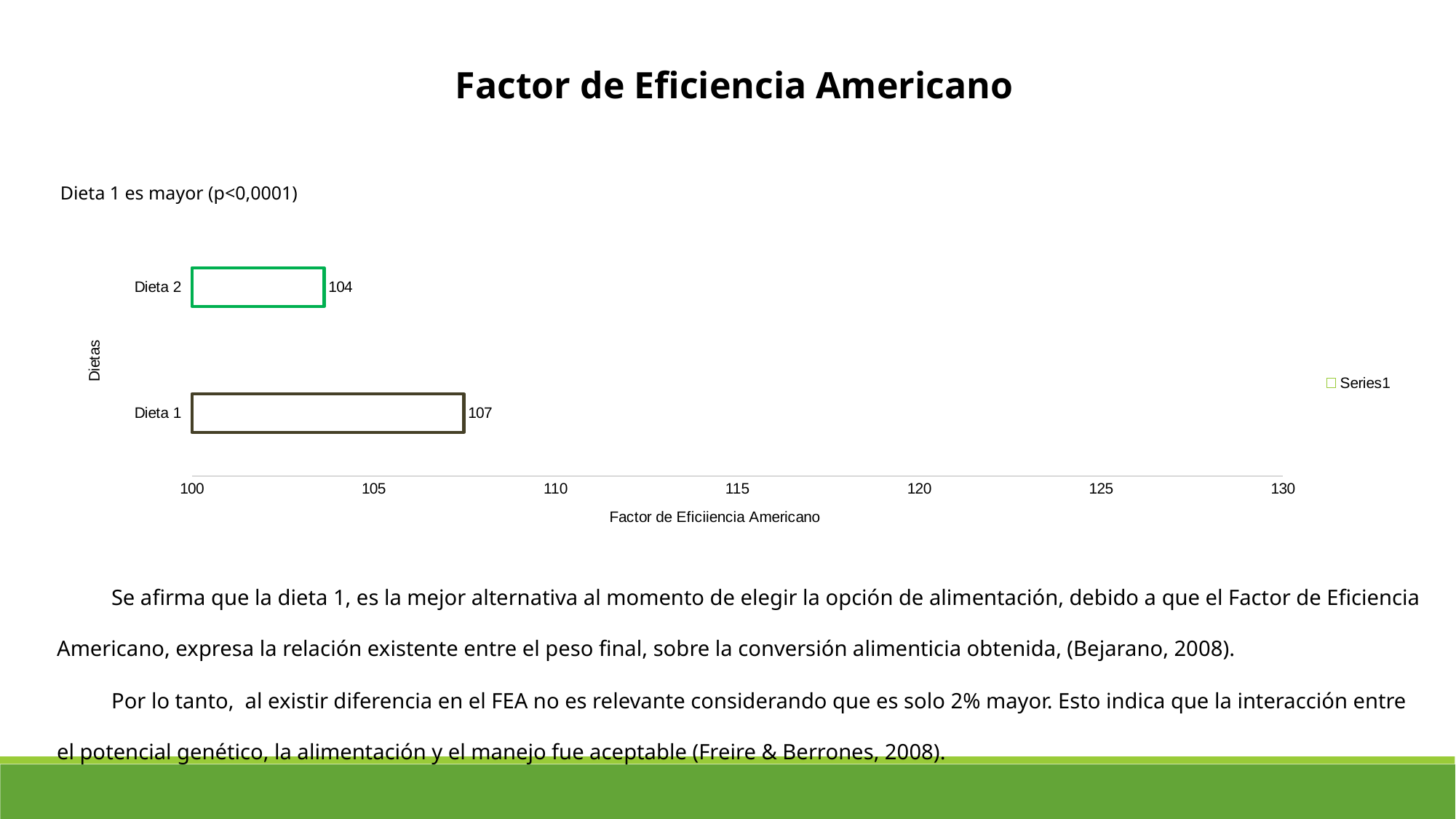
What kind of chart is shown on the slide? bar chart Which diet has the lowest Factor de Eficiencia Americano? Dieta 2 What is the difference between the values for Dieta 1 and Dieta 2? 3 Is the value for Dieta 1 greater or less than 105? greater What is the value for Dieta 1? 107 How many diets are shown in the chart? 2 Is the value for Dieta 2 greater or less than 105? less How many series does the legend list? 1 What is the value for Dieta 2? 104 Which diet has the highest Factor de Eficiencia Americano? Dieta 1 What is the label of the horizontal axis of the chart? Factor de Eficiiencia Americano Which is larger, the value for Dieta 1 or the value for Dieta 2? Dieta 1